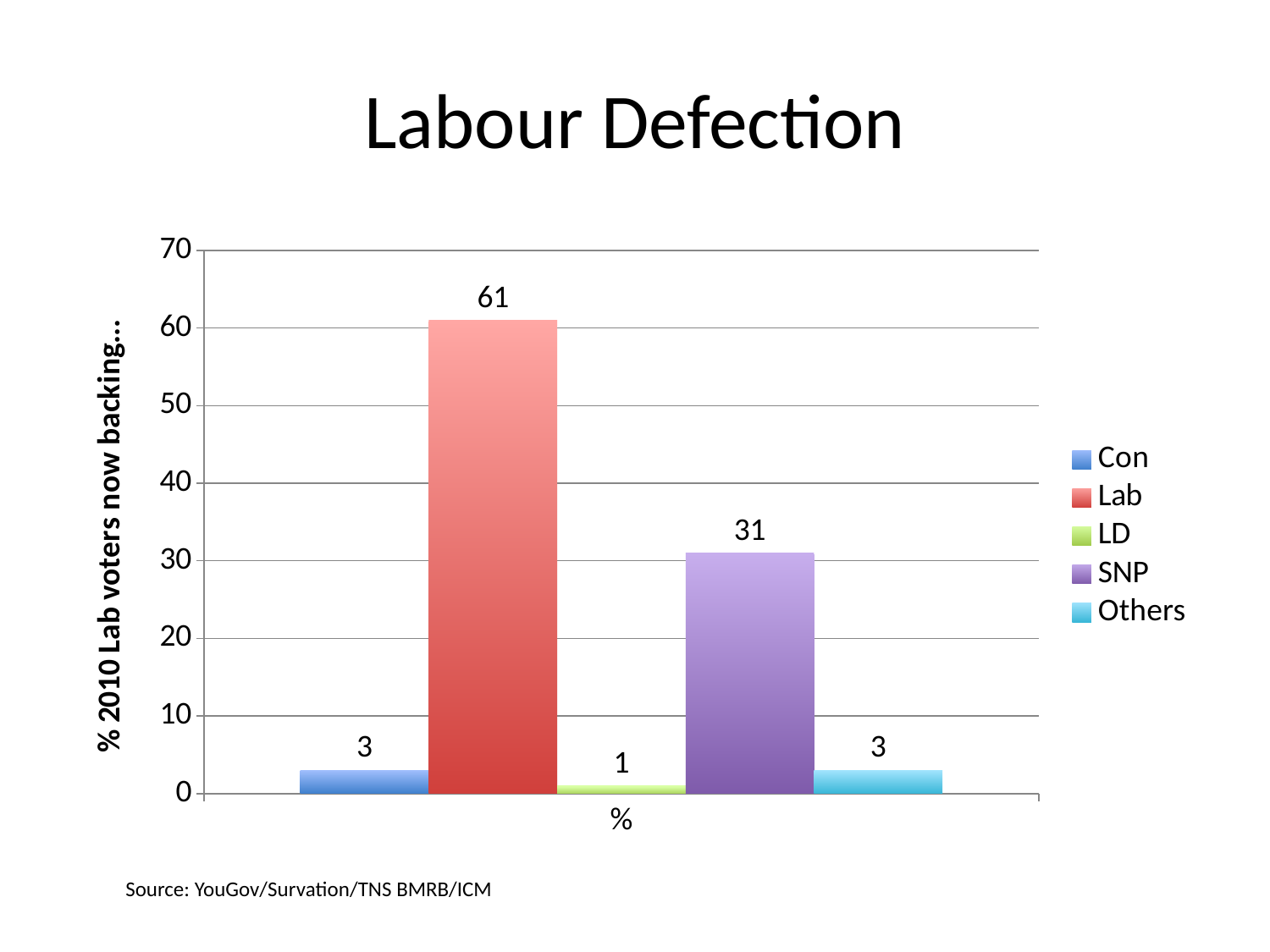
What kind of chart is shown on the slide? bar chart Which is larger, the value for SNP or the value for Others? SNP What is the value for Con? 3 What is the difference between the values for Lab and SNP? 30 What is the title of the chart? Labour Defection What is the value for SNP? 31 How many series does the legend list? 5 What is the value for Lab? 61 What is the value for LD? 1 Which series has the lowest value? LD Is the value for Lab greater or less than 50? greater Which series has the highest value? Lab